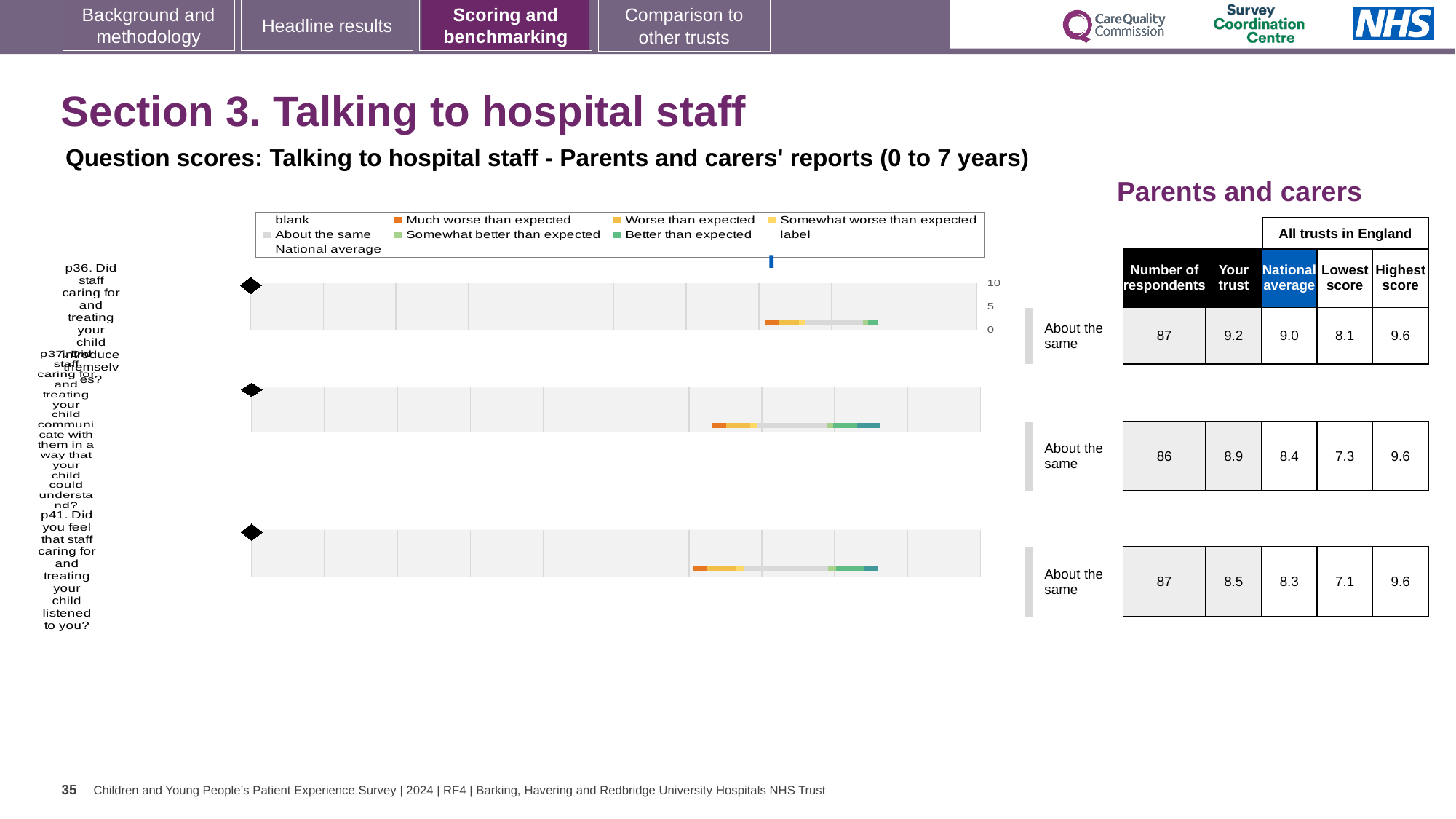
For the bottom chart (p41), what is the Lowest score in the table? 7.1 What is the highest tick value shown on the score axis of the top chart? 10 How many question-score charts are shown on the slide? 3 What is the benchmark result shown next to the top chart (p36)? About the same Is the 'Your trust' score for p41 larger or smaller than the National average for p41? larger What kind of chart is used for the three question-score charts on the slide? bar chart For the middle chart (p37), what is the National average score in the table? 8.4 For the top chart (p36), what is the 'Your trust' score in the table? 9.2 What is the benchmark result shown next to the bottom chart (p41)? About the same What is the difference between the 'Your trust' score and the National average for p37? 0.5 In the chart legend, which category is shown in orange? Much worse than expected Which question has the highest 'Your trust' score: p36, p37 or p41? p36